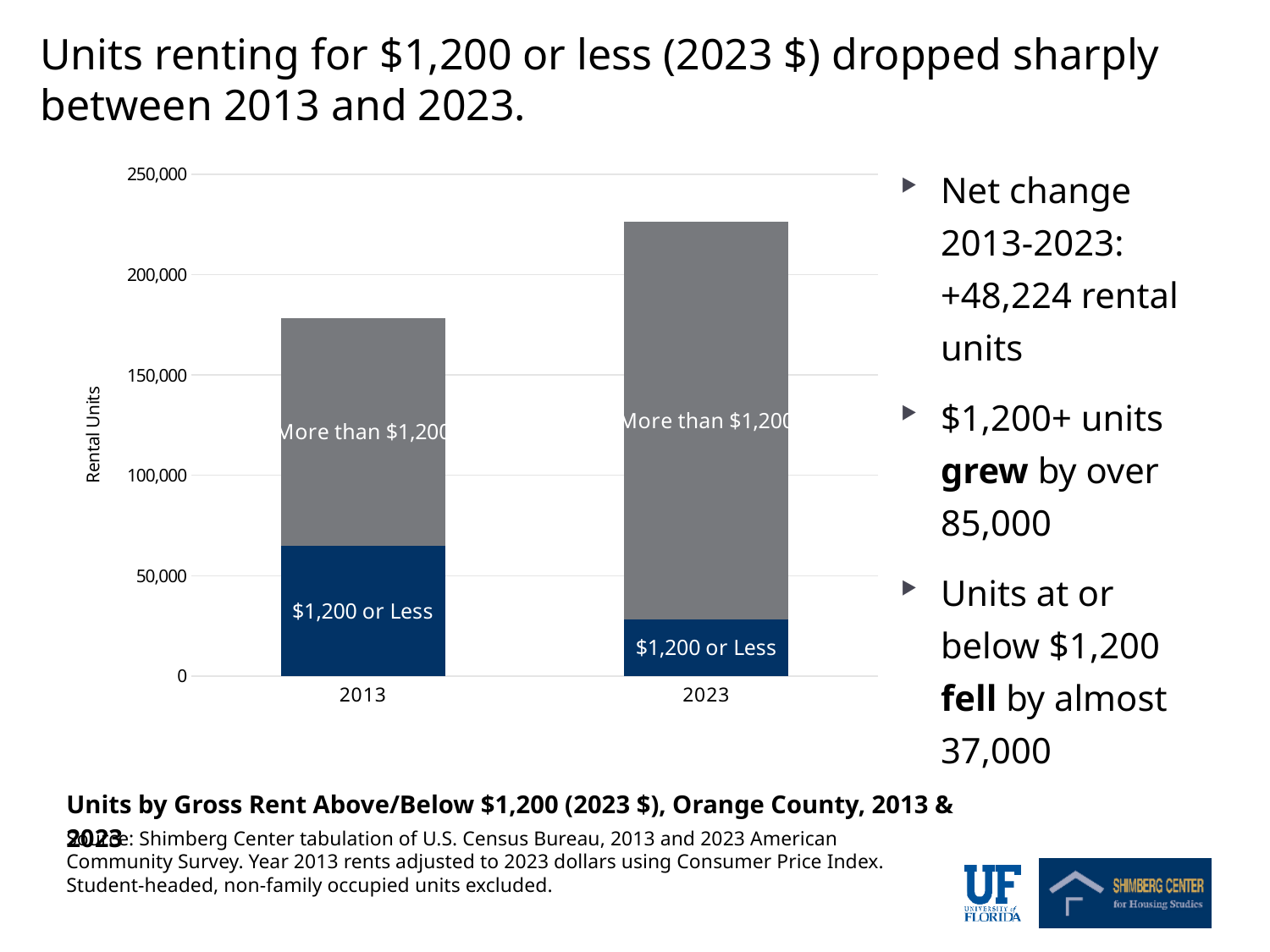
Is the value for the $1,200 or Less segment in 2023 greater or less than 50,000? less Is the value for the $1,200 or Less segment in 2013 greater or less than 50,000? greater Does the $1,200 or Less segment rise or fall from 2013 to 2023? Fall What is the label on the vertical axis of the chart? Rental Units Which year has the taller total bar, 2013 or 2023? 2023 Is the total height of the 2023 bar greater or less than 200,000? greater Which year has the larger $1,200 or Less segment, 2013 or 2023? 2013 What is the title of the chart printed below it? Units by Gross Rent Above/Below $1,200 (2023 $), Orange County, 2013 & 2023 What kind of chart is shown on the slide? Stacked bar chart How many years (categories) are shown on the x axis of the chart? 2 How many rent segments are stacked in each bar of the chart? 2